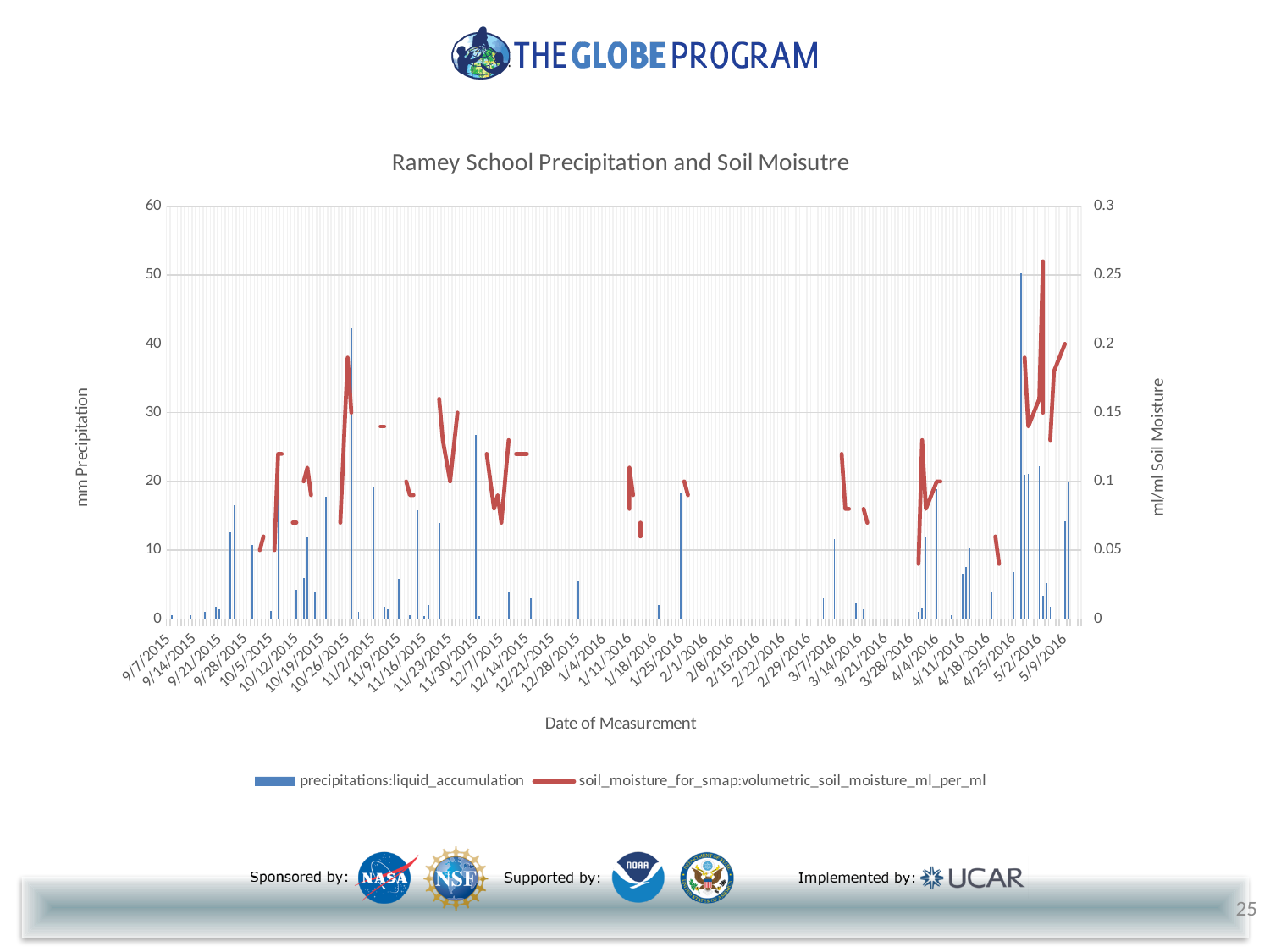
Which series is drawn as a red line? soil_moisture_for_smap:volumetric_soil_moisture_ml_per_ml Is the tallest precipitation bar on the chart greater or less than 40 mm? greater Which is larger: the tallest precipitation bar near 10/26/2015 or the tallest precipitation bar near 5/2/2016? the bar near 5/2/2016 Is the precipitation bar near 11/30/2015 greater or less than 20 mm? greater How many series does the chart legend list? 2 Is the highest soil moisture value on the chart greater or less than 0.2 ml/ml? greater What is the title of the chart? Ramey School Precipitation and Soil Moisutre What kind of chart is shown on the slide? Combined bar and line chart